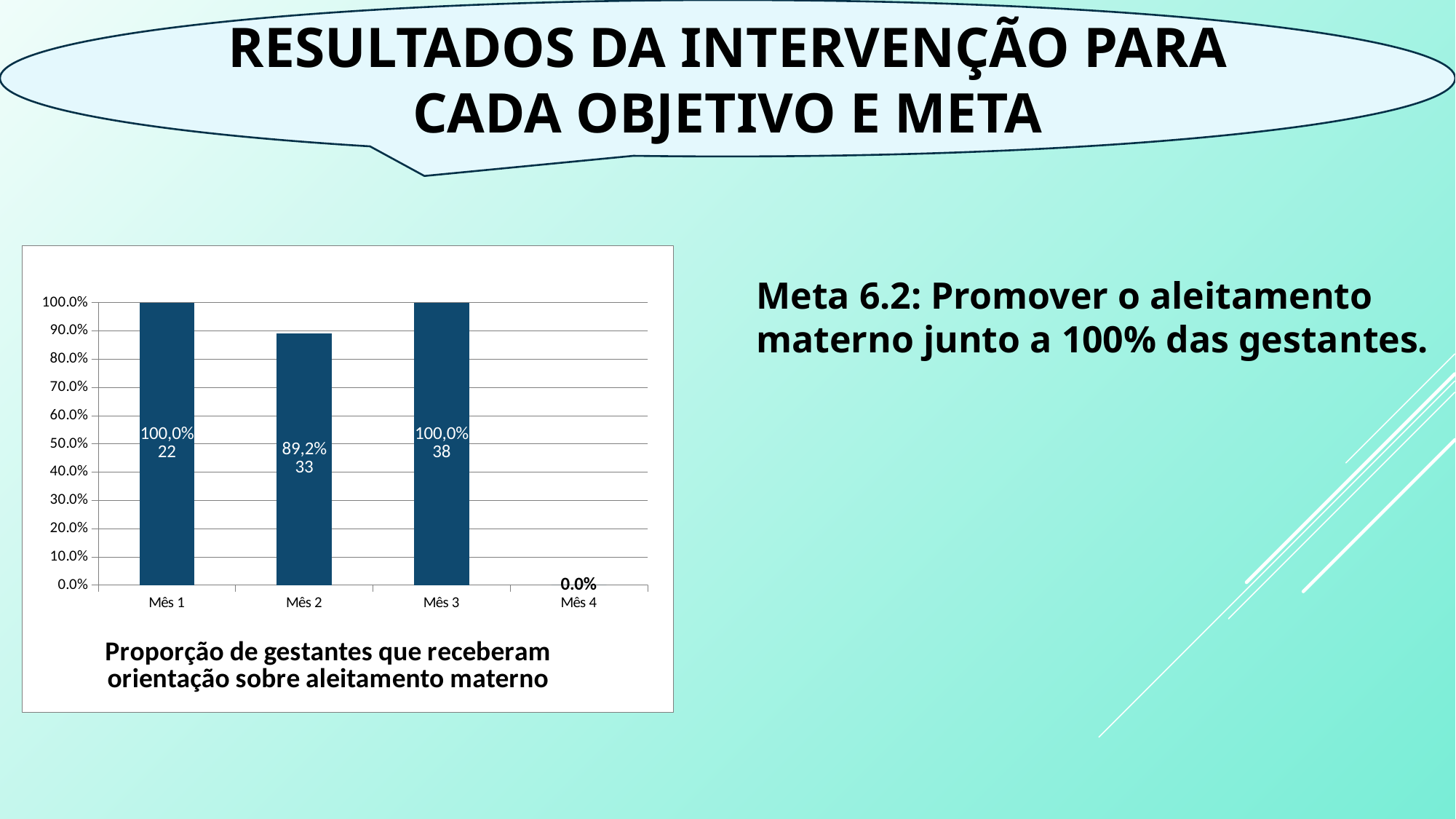
What is the value shown for Mês 4? 0.0% How many months are shown on the x axis? 4 What is the value shown for Mês 2? 89,2% Which is larger, the value for Mês 2 or the value for Mês 3? Mês 3 Which month has the lowest value? Mês 4 What is the value shown for Mês 1? 100,0% What kind of chart is shown on the slide? bar chart What is the title of the chart? Proporção de gestantes que receberam orientação sobre aleitamento materno What count is printed inside the bar for Mês 3? 38 What count is printed inside the bar for Mês 2? 33 Is the value for Mês 2 greater or less than 80%? greater What is the difference between the percentage for Mês 1 and the percentage for Mês 2? 10,8%